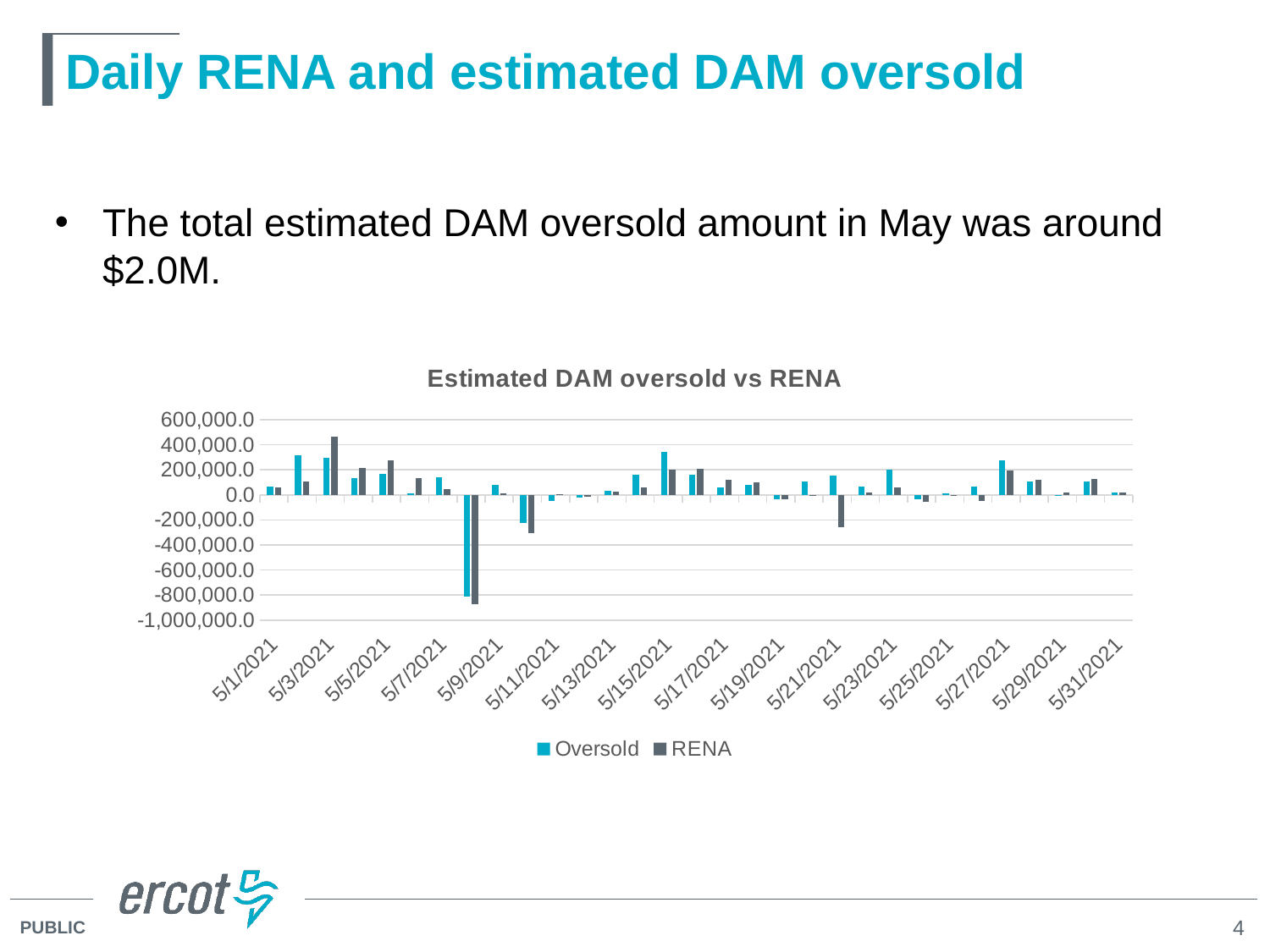
What is the lowest value shown on the y axis of the chart? -1,000,000.0 Is the RENA value for 5/3/2021 greater or less than 200,000.0? greater Is the Oversold value for 5/15/2021 greater or less than 200,000.0? greater Is the Oversold value for 5/9/2021 greater or less than 200,000.0? less What are the two series named in the chart legend? Oversold and RENA What is the title of the chart? Estimated DAM oversold vs RENA What kind of chart is shown on the slide? bar chart How many date labels are shown along the x axis of the chart? 16 On 5/3/2021, which series has the larger value, Oversold or RENA? RENA On 5/15/2021, which series has the larger value, Oversold or RENA? Oversold How many series does the legend of the chart list? 2